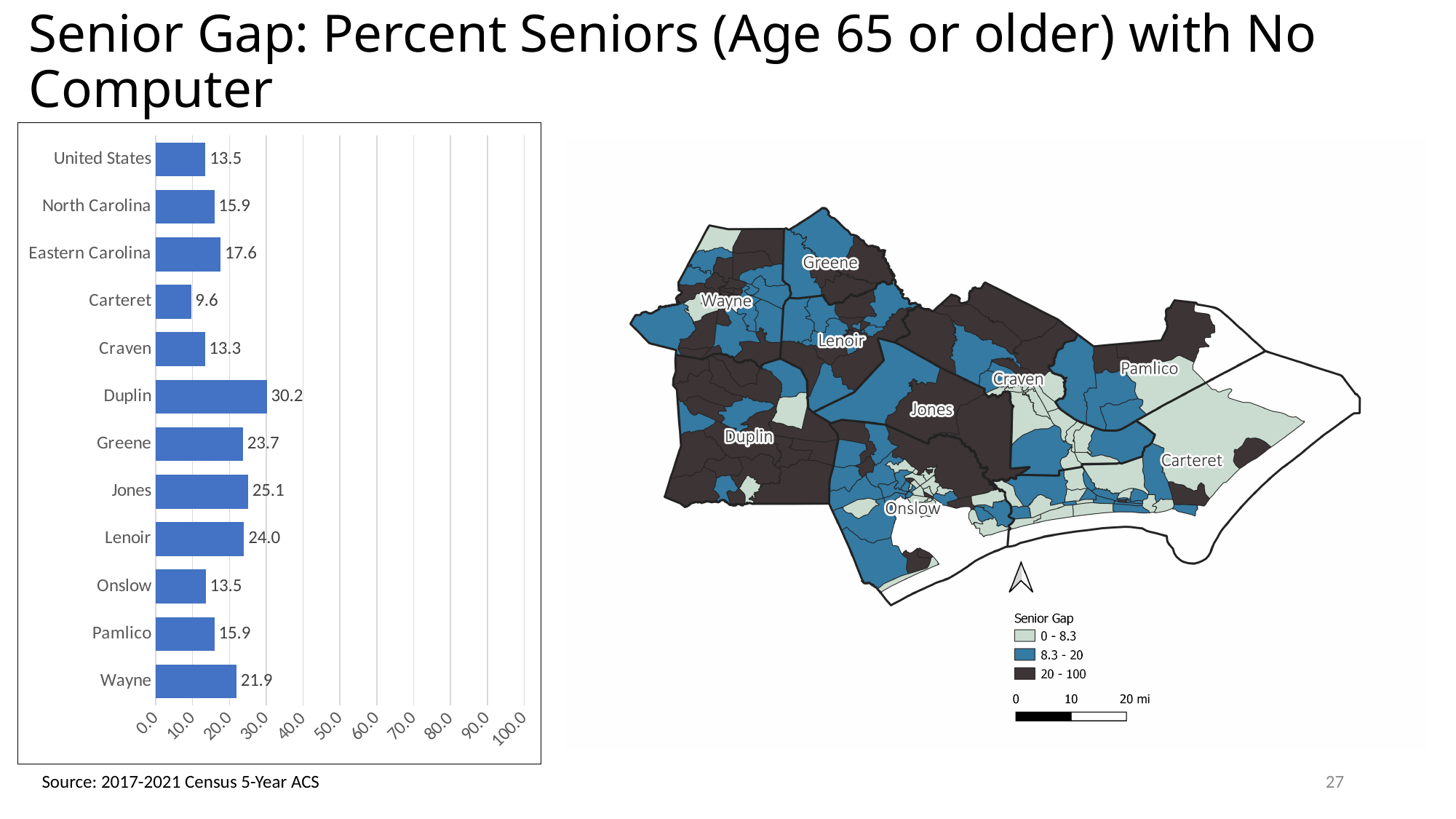
What is the value for Eastern Carolina in the bar chart? 17.6 Which category has the lowest value in the bar chart? Carteret How many categories are shown in the bar chart? 12 What is the difference between the values for Jones and Lenoir in the bar chart? 1.1 What is the highest value shown on the x axis of the bar chart? 100.0 Which category has the highest value in the bar chart? Duplin What is the value for Duplin in the bar chart? 30.2 In the bar chart, which is larger, the value for Greene or the value for Wayne? Greene What is the difference between the values for Duplin and Carteret in the bar chart? 20.6 Is the value for Lenoir in the bar chart greater or less than 20.0? greater What kind of chart is shown on the left of the slide? Bar chart What is the value for Carteret in the bar chart? 9.6